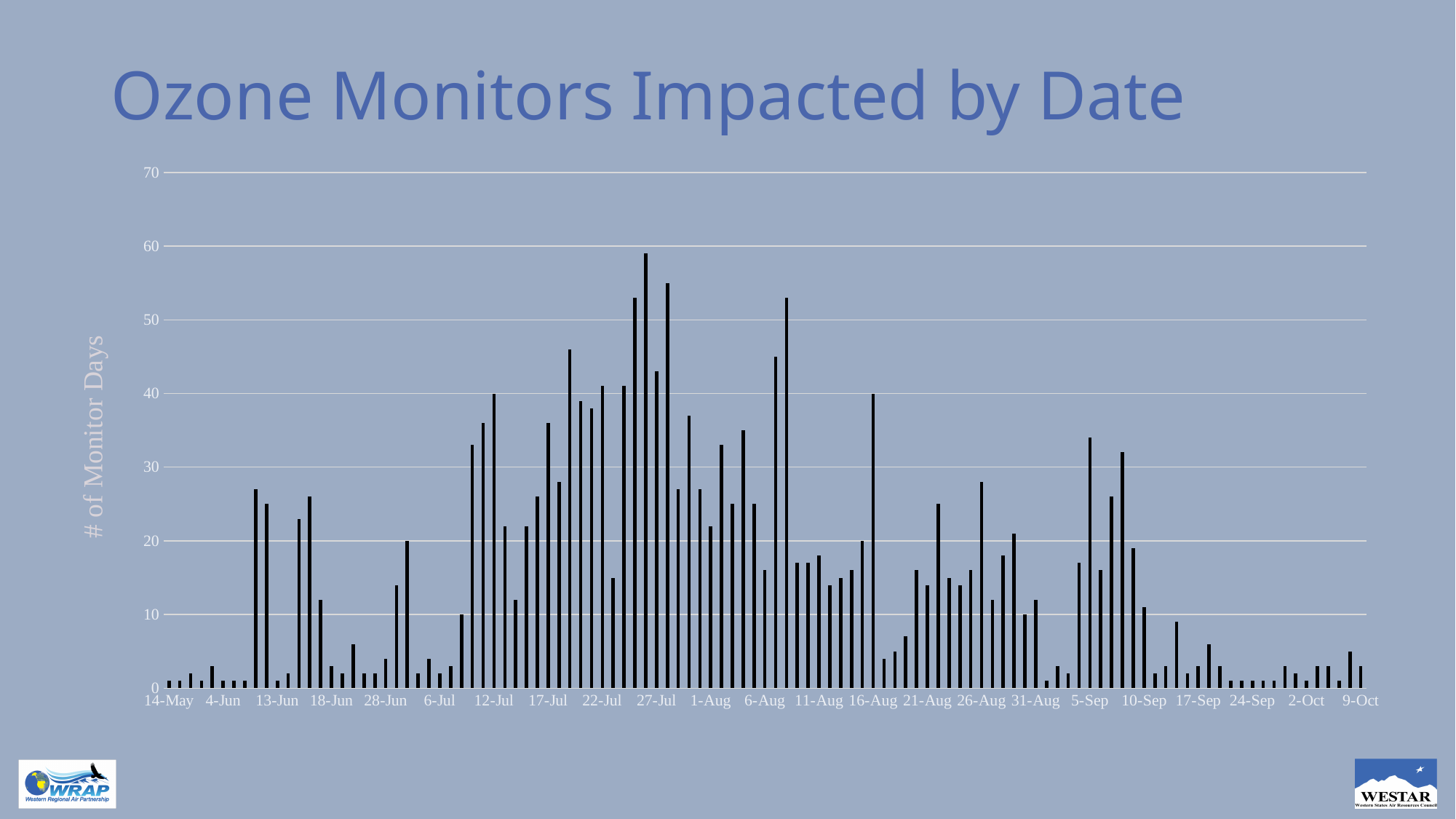
What kind of chart is shown on the slide? bar chart Is the value for 5-Sep greater or less than 30? greater Which has the larger value, 12-Jul or 14-May? 12-Jul Is the tallest bar in the chart greater or less than 50? greater What is the label on the vertical axis of the chart? # of Monitor Days Is the value for 14-May greater or less than 10? less What is the title of the chart? Ozone Monitors Impacted by Date